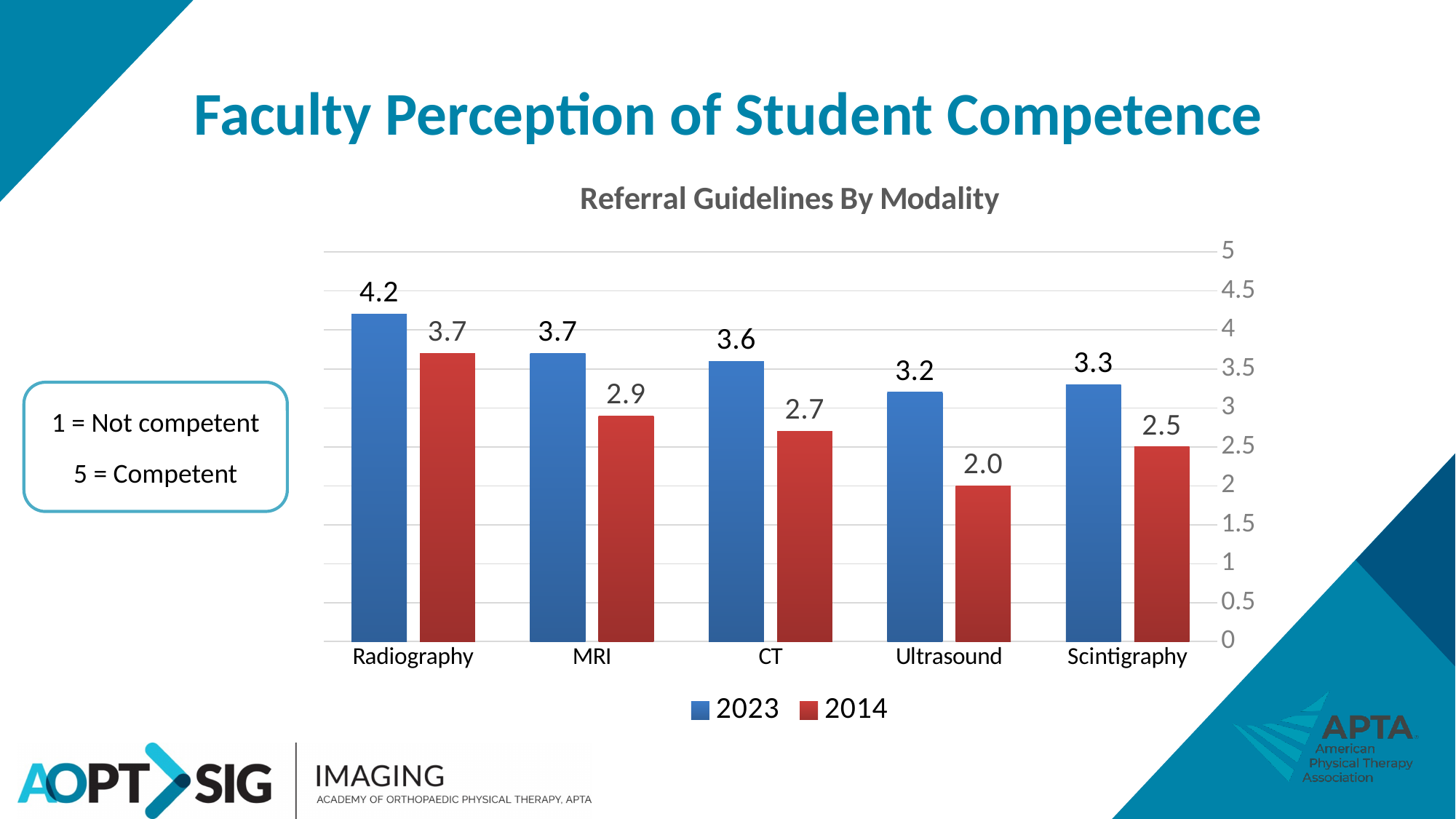
What is the 2014 value for Scintigraphy? 2.5 What is the 2014 value for Ultrasound? 2.0 Is the 2014 value for CT greater or less than 3? less How many series does the legend list? 2 What is the 2023 value for Radiography? 4.2 How many modalities are shown on the x axis? 5 Which is larger, the 2023 value for CT or the 2023 value for Scintigraphy? CT Which modality has the lowest 2014 value? Ultrasound What is the difference between the 2023 and 2014 values for Ultrasound? 1.2 Which modality has the highest 2023 value? Radiography What type of chart is shown? bar chart What is the difference between the 2023 and 2014 values for MRI? 0.8